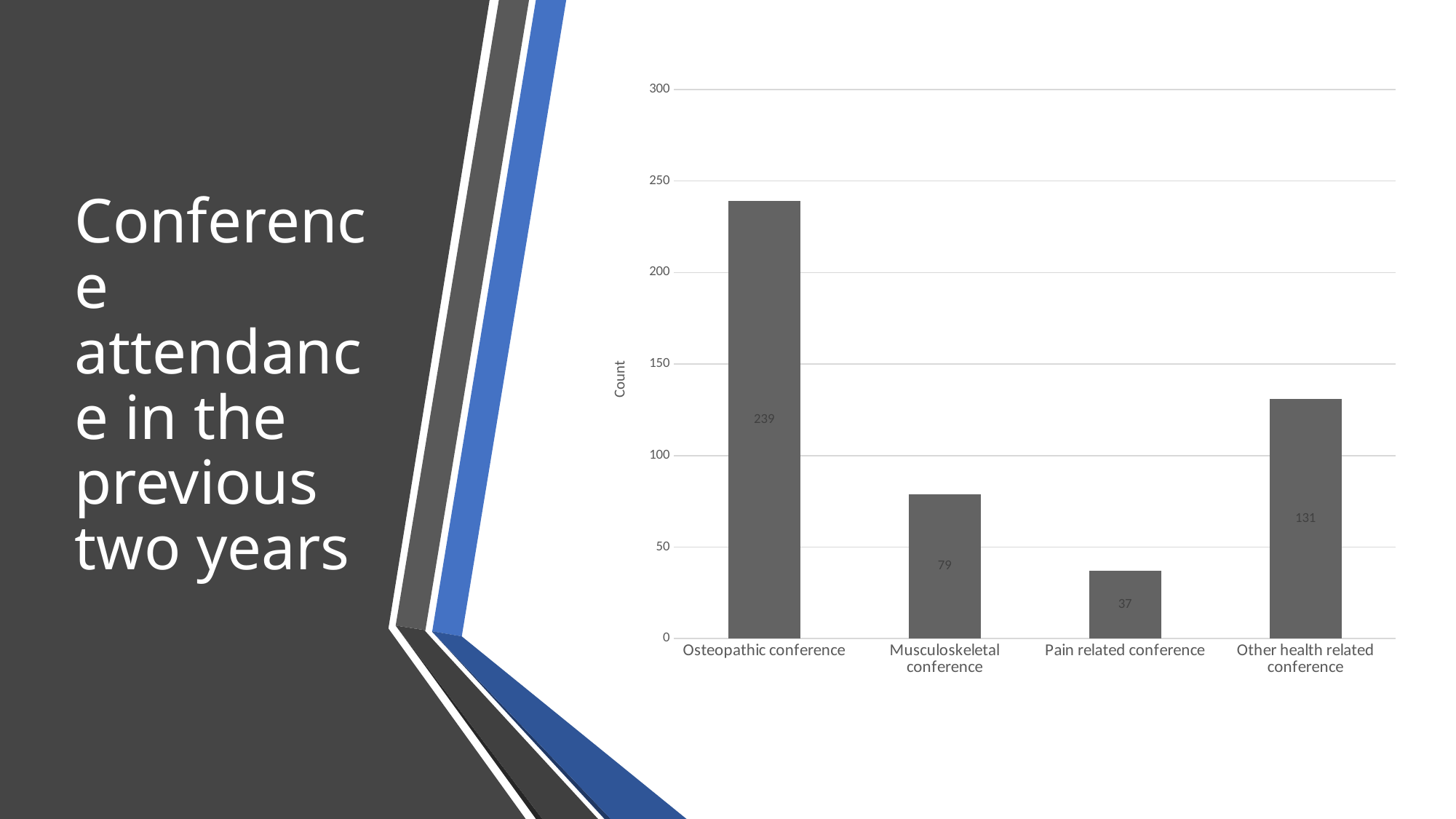
What is the difference between the counts for Osteopathic conference and Other health related conference? 108 Which conference type has the highest count? Osteopathic conference Which has a larger count, Musculoskeletal conference or Other health related conference? Other health related conference Which conference type has the lowest count? Pain related conference What is the label on the vertical axis of the chart? Count What is the count for Other health related conference? 131 Is the value for Musculoskeletal conference greater or less than 100? less What kind of chart is shown on the slide? bar chart What is the count for Pain related conference? 37 How many conference categories are shown on the chart? 4 What is the count for Osteopathic conference? 239 What is the count for Musculoskeletal conference? 79